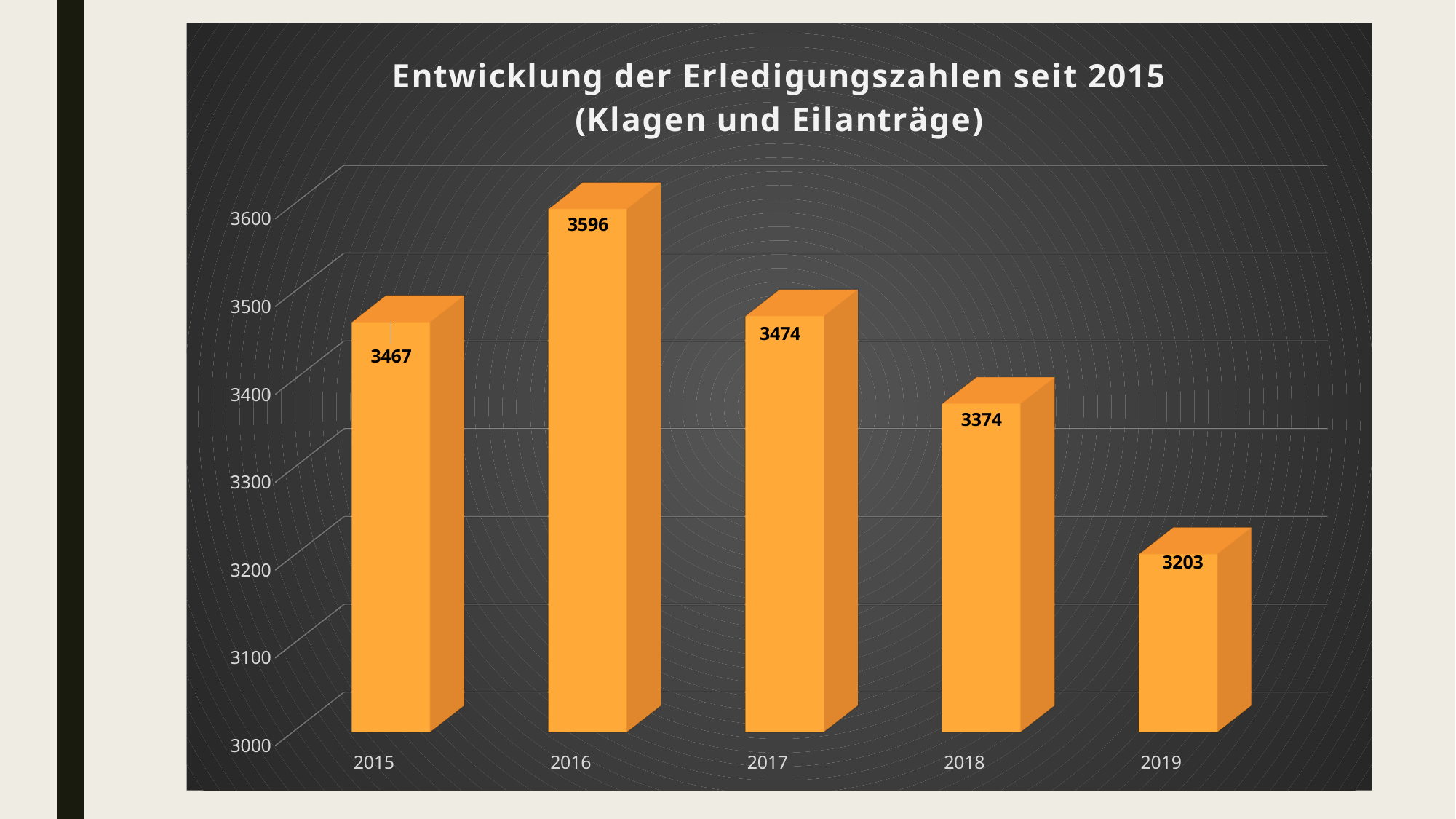
What is the difference between the values for 2017 and 2018? 100 Which is larger, the value for 2015 or the value for 2017? 2017 Do the values rise or fall from 2016 to 2019? fall What is the difference between the values for 2016 and 2019? 393 What is the value for 2015? 3467 What is the value for 2016? 3596 What kind of chart is shown on the slide? bar chart Which year has the highest value? 2016 What is the value for 2019? 3203 How many years are shown on the x axis? 5 Is the value for 2018 greater or less than 3400? less Which year has the lowest value? 2019